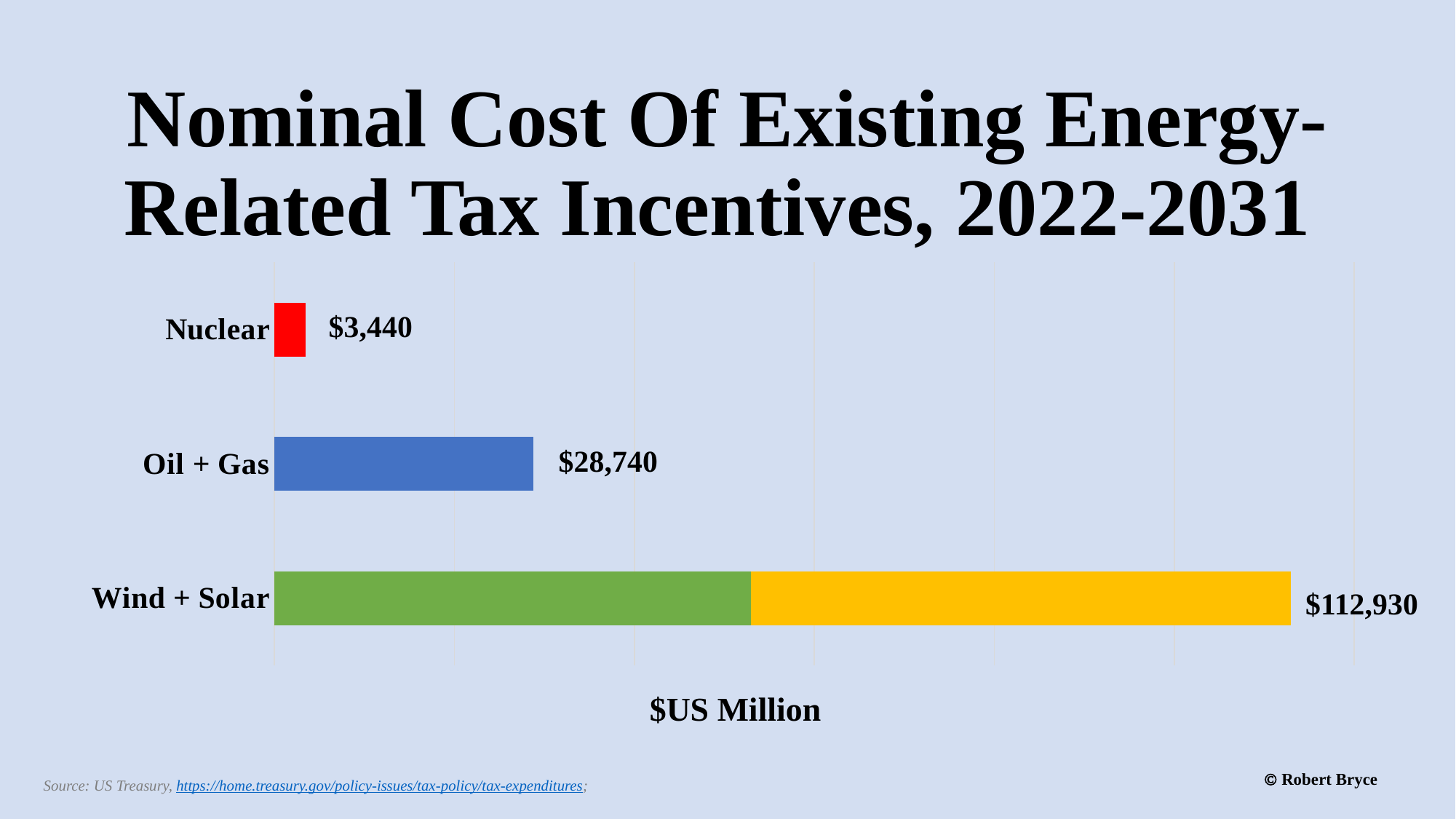
What is the value for Oil + Gas? $28,740 What is the difference between the values for Oil + Gas and Nuclear? $25,300 Which is larger, the value for Oil + Gas or the value for Nuclear? Oil + Gas What kind of chart is shown on the slide? Bar chart Which category has the lowest value? Nuclear What is the difference between the values for Wind + Solar and Oil + Gas? $84,190 What colour is the bar for Nuclear? Red What unit is given on the axis label below the chart? $US Million How many categories are shown in the chart? 3 What is the value for Nuclear? $3,440 Which category has the highest value? Wind + Solar What is the value for Wind + Solar? $112,930